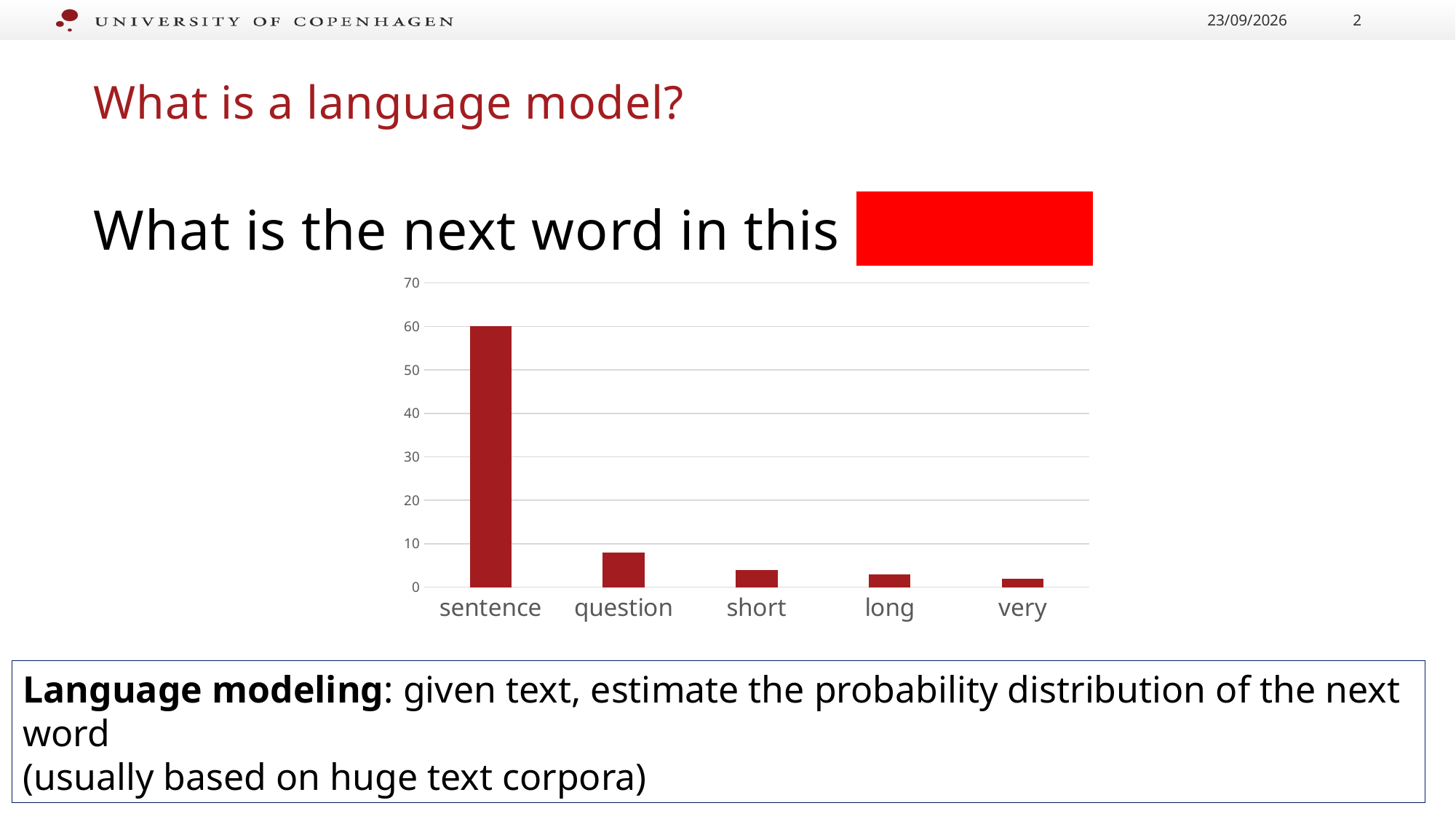
Do the bar values rise or fall from left to right along the x axis? fall Is the value for "sentence" greater or less than 50? greater Is the value for "short" greater or less than 10? less What is the label of the first category on the x axis of the chart? sentence What kind of chart is shown on the slide? bar chart Which category has the highest bar in the chart? sentence Is the value for "question" greater or less than 10? less Which is larger, the value for "sentence" or the value for "question"? sentence What is the value for "sentence" in the chart? 60 What is the highest value shown on the chart's y axis? 70 How many categories are shown on the x axis of the chart? 5 Which is larger, the value for "question" or the value for "very"? question